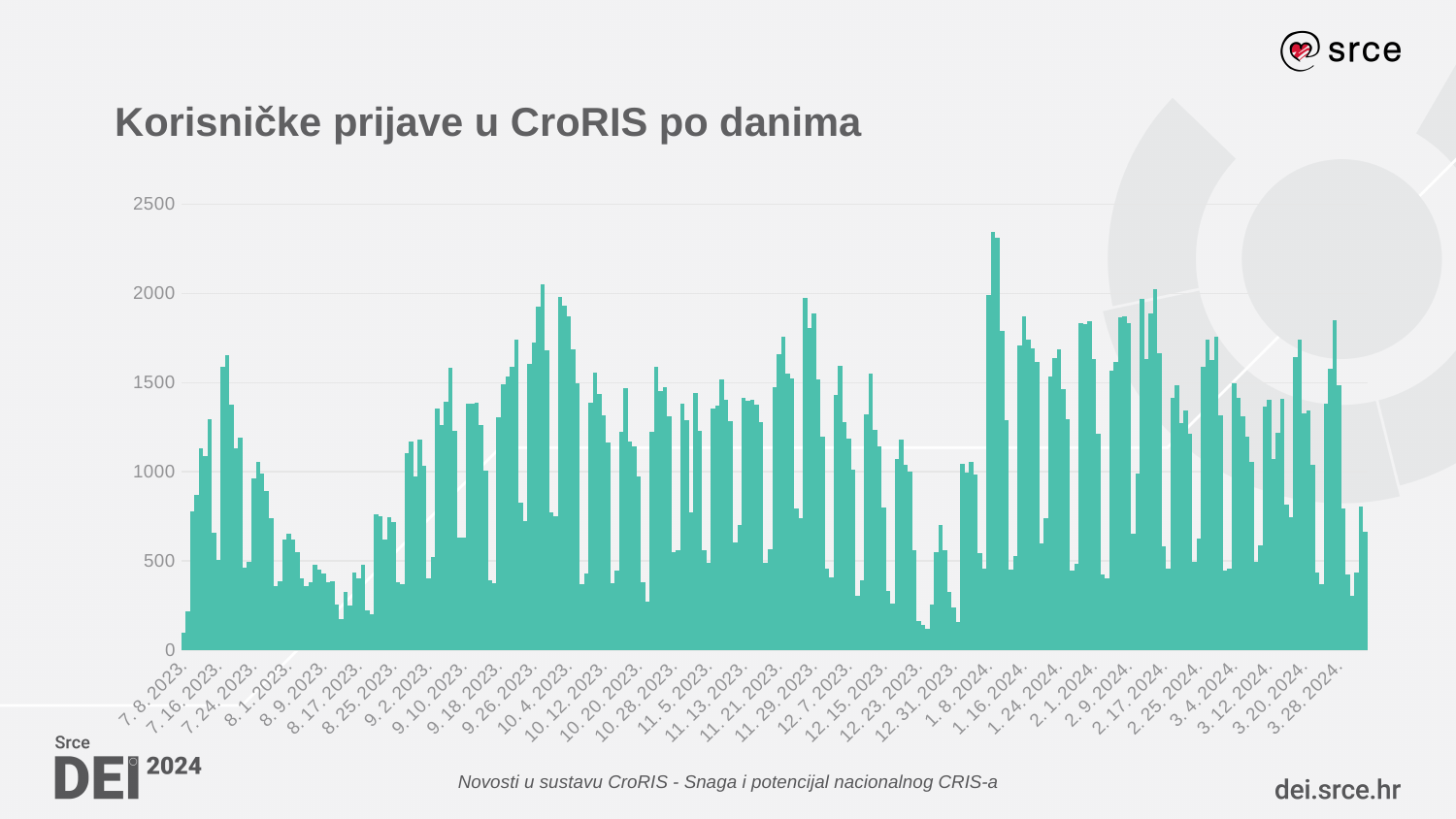
Which is larger: the value around 8.9.2023. or the value around 9.26.2023.? 9.26.2023. In which month does the tallest bar of the chart occur? January 2024 What is the title of the chart? Korisničke prijave u CroRIS po danima Is the highest bar in the chart greater or less than 2500? less Which is larger: the peak around 9.26.2023. or the peak around 1.8.2024.? 1.8.2024. What is the highest value shown on the vertical axis? 2500 Is the value for the first day shown (7.8.2023.) greater or less than 500? less Is the highest bar in the chart greater or less than 2000? greater What is the first date label on the horizontal axis? 7.8.2023. What kind of chart is shown on the slide? bar chart